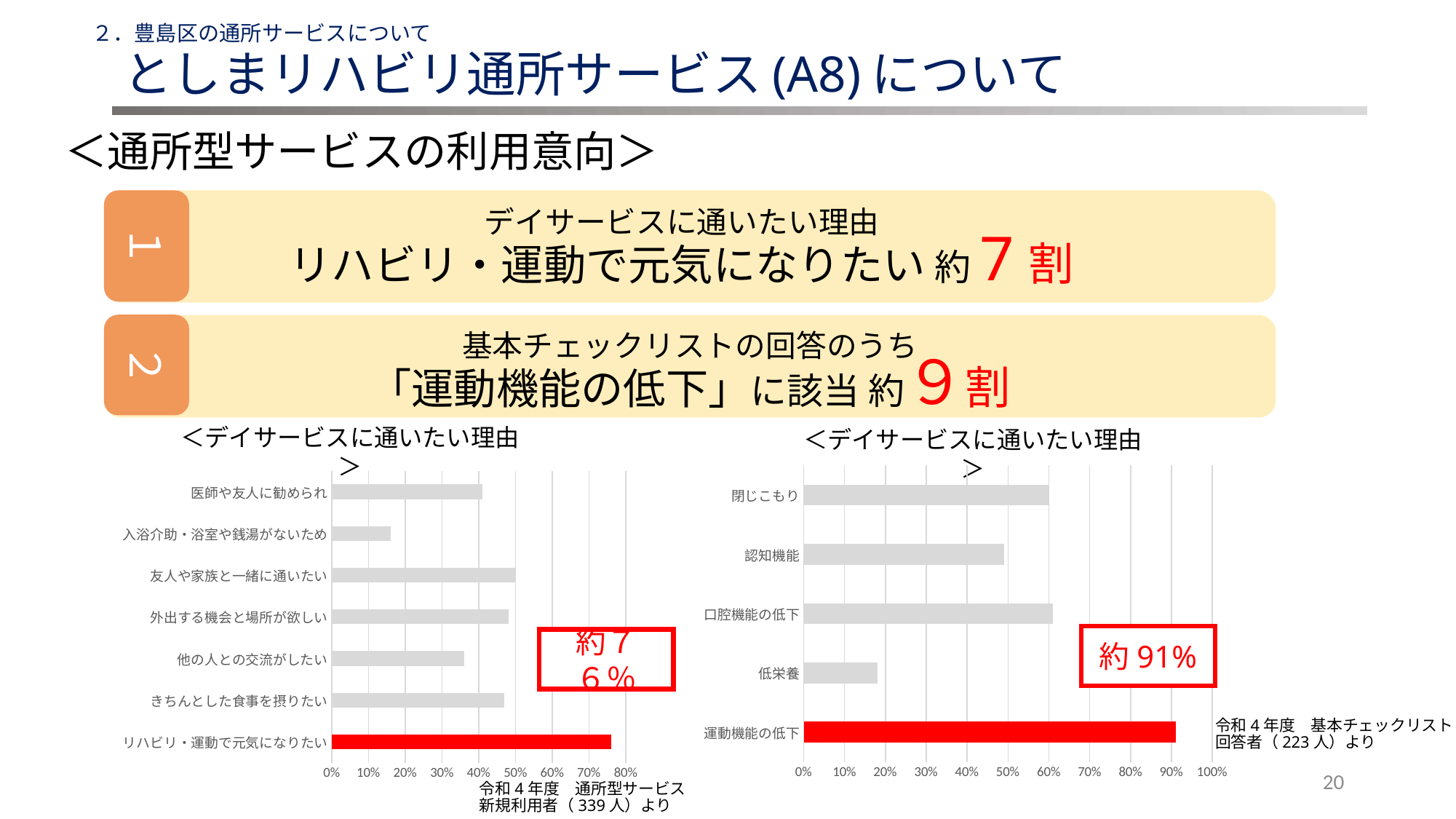
In the right chart, is the value for 運動機能の低下 greater or less than 80%? greater What kind of chart is the left chart on the slide? bar chart In the right chart, which category has the highest value? 運動機能の低下 In the right chart, which category has the lowest value? 低栄養 In the left chart, which category has the lowest value? 入浴介助・浴室や銭湯がないため In the left chart, which category has the highest value? リハビリ・運動で元気になりたい In the left chart, is the value for 医師や友人に勧められ greater or less than 50%? less In the right chart, is the value for 認知機能 greater or less than 60%? less In the left chart, which is larger: 友人や家族と一緒に通いたい or 他の人との交流がしたい? 友人や家族と一緒に通いたい In the right chart, how many categories are plotted? 5 In the right chart, what colour is the bar for 運動機能の低下? red In the left chart, how many categories are plotted? 7